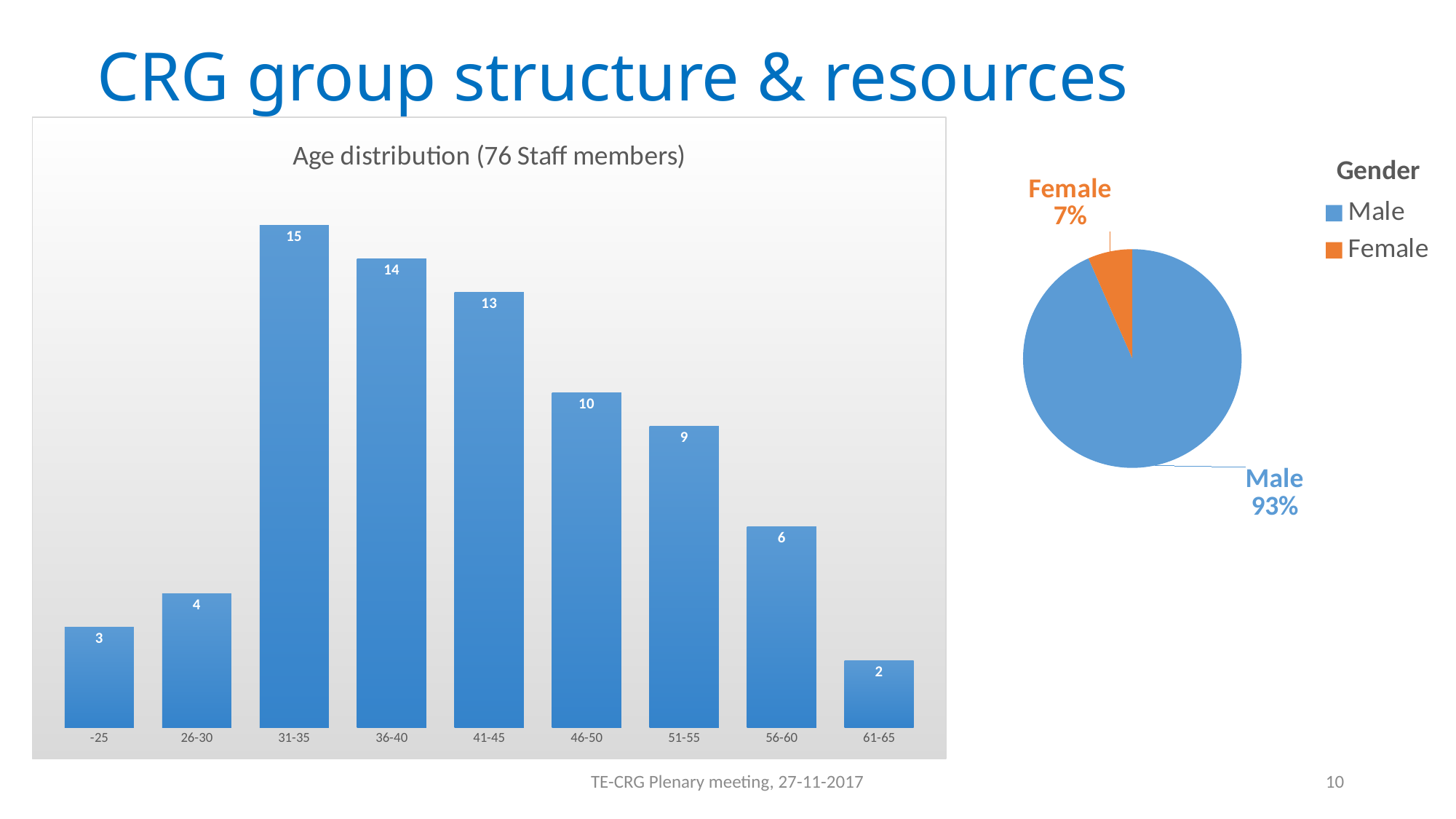
In the 'Age distribution (76 Staff members)' chart, which age group has the highest value? 31-35 How many entries does the legend of the 'Gender' pie chart list? 2 In the 'Gender' pie chart, what share is Male? 93% How many age groups are shown in the 'Age distribution (76 Staff members)' chart? 9 In the 'Age distribution (76 Staff members)' chart, what is the difference between the values for 36-40 and 56-60? 8 What kind of chart is the 'Age distribution (76 Staff members)' chart? bar chart In the 'Age distribution (76 Staff members)' chart, which age group has the lowest value? 61-65 In the 'Age distribution (76 Staff members)' chart, do the values rise or fall from the 31-35 group to the 61-65 group? fall In the 'Gender' pie chart, what share is Female? 7% In the 'Age distribution (76 Staff members)' chart, what is the value for the 46-50 age group? 10 In the 'Age distribution (76 Staff members)' chart, what is the value for the 31-35 age group? 15 In the 'Age distribution (76 Staff members)' chart, which is larger, the value for 26-30 or the value for 51-55? 51-55